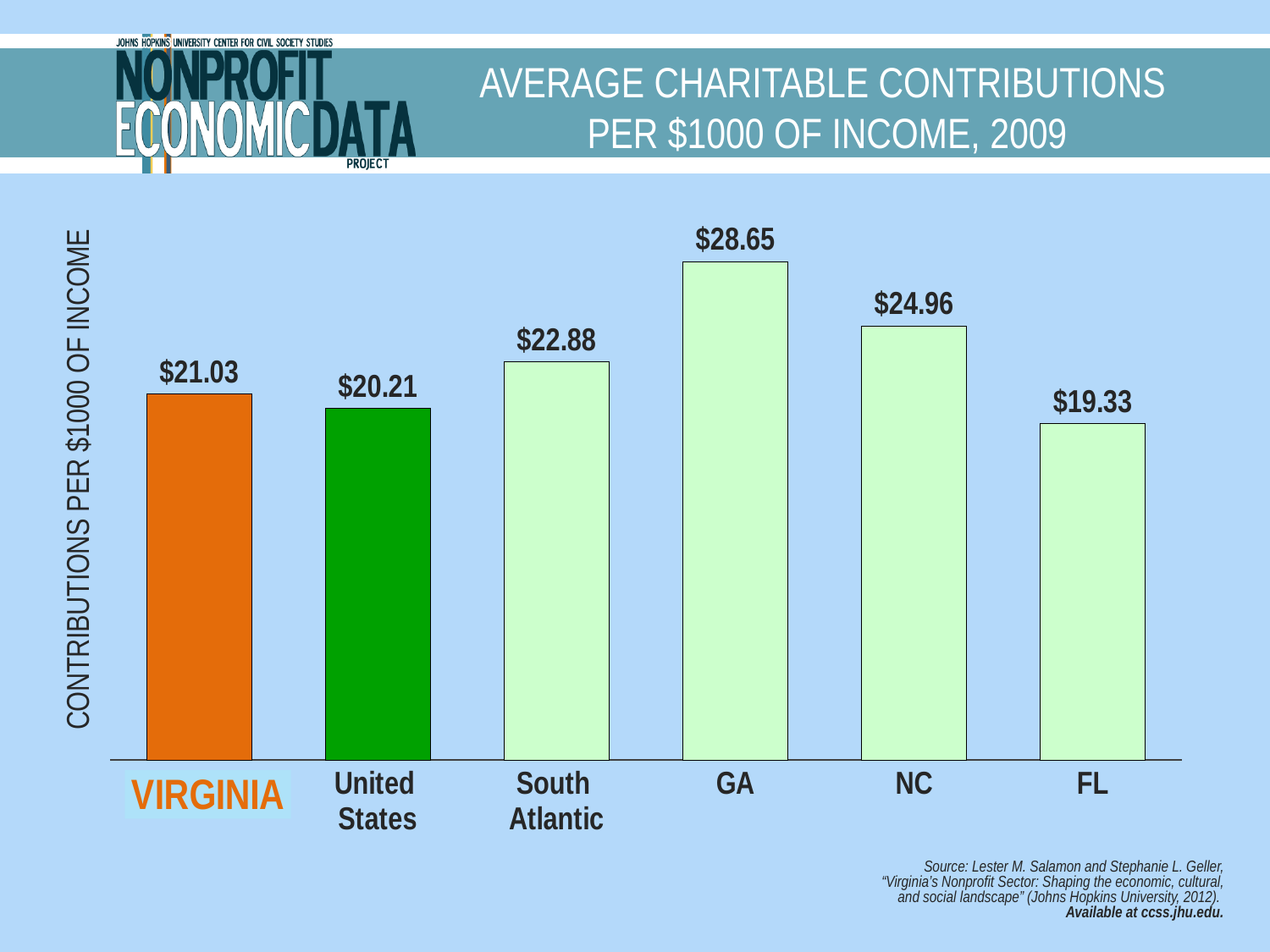
How many categories are shown on the chart? 6 What is the value shown for FL? $19.33 Which category has the lowest average charitable contributions per $1000 of income? FL What is the difference between the values for Virginia and the United States? $0.82 What kind of chart is shown on the slide? Bar chart What is the value shown for GA? $28.65 What is the title of the chart? Average Charitable Contributions per $1000 of Income, 2009 Which category has the highest average charitable contributions per $1000 of income? GA What is the average charitable contribution per $1000 of income for Virginia? $21.03 Which is larger, the value for South Atlantic or the value for Virginia? South Atlantic What is the difference between the values for GA and NC? $3.69 What is the value shown for the United States? $20.21